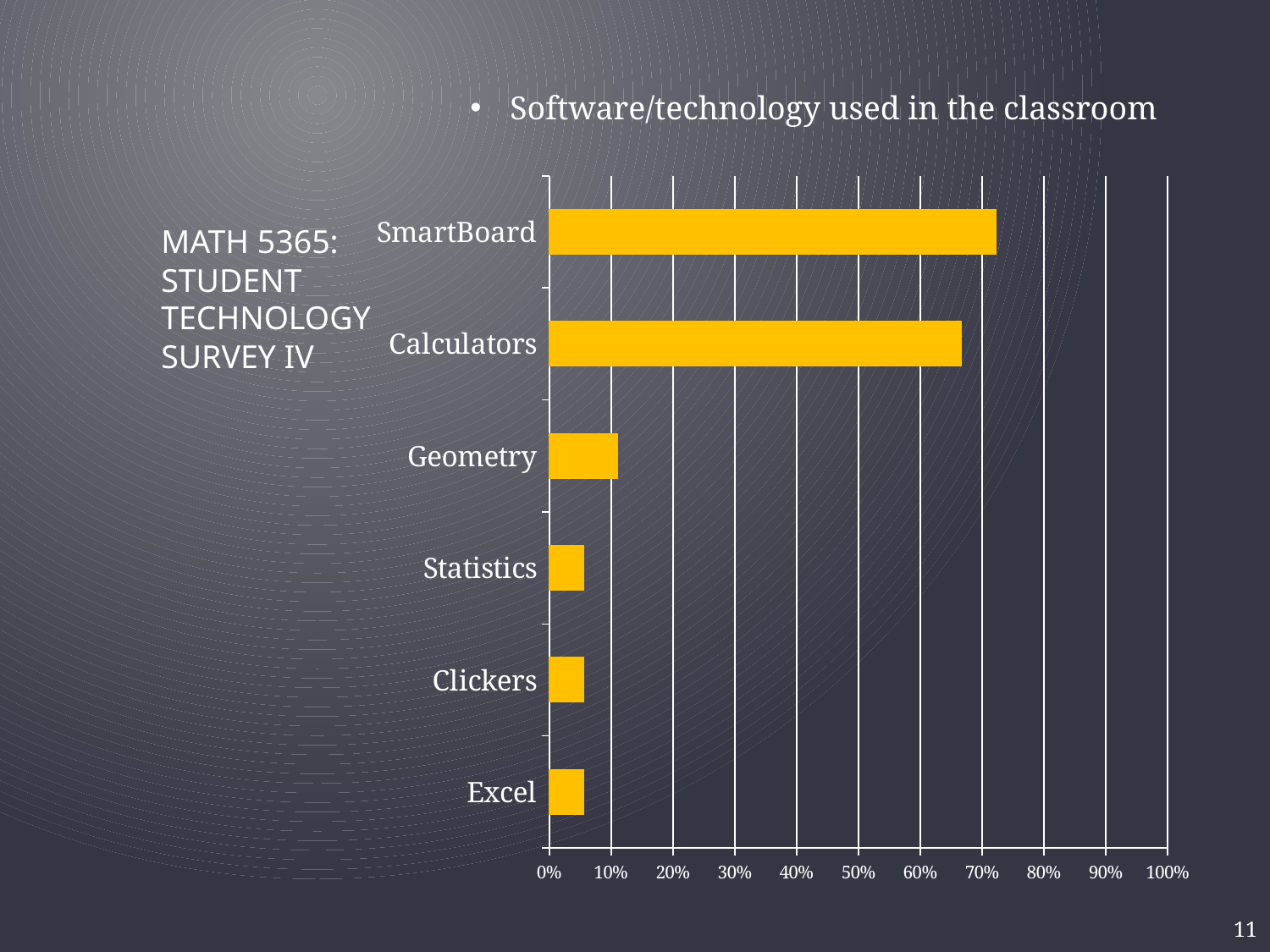
Which category has the highest value in the chart? SmartBoard What kind of chart is shown on the slide? bar chart Is the value for Calculators greater or less than 50%? greater Is the value for SmartBoard greater or less than 60%? greater Is the value for Calculators greater or less than 70%? less Which is larger, the value for Geometry or the value for Clickers? Geometry Which is larger, the value for Calculators or the value for Geometry? Calculators How many categories are plotted in the chart? 6